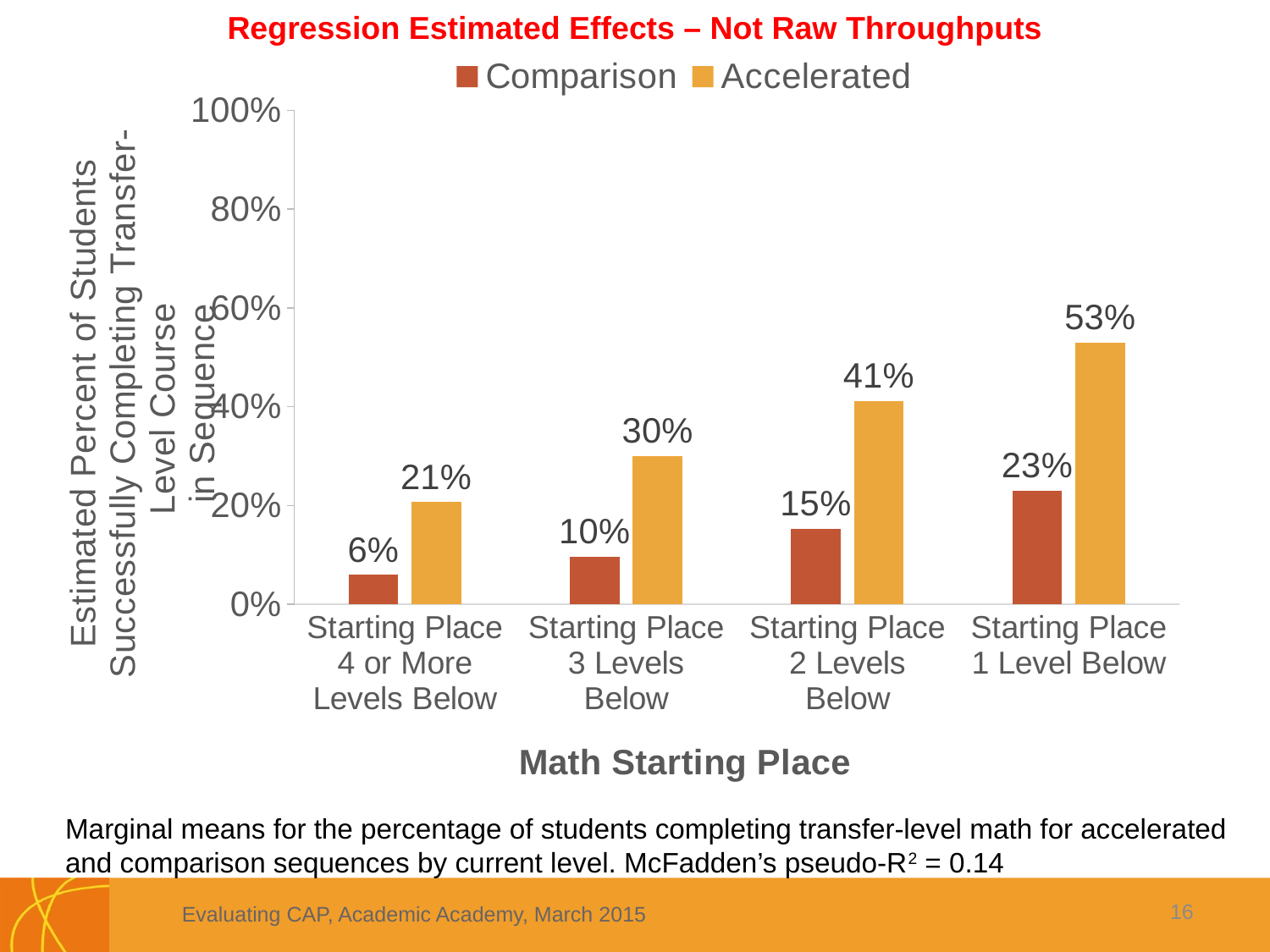
Which is larger: the Comparison value for Starting Place 1 Level Below or the Accelerated value for Starting Place 4 or More Levels Below? Comparison value for Starting Place 1 Level Below What is the difference between the Accelerated and Comparison values for Starting Place 3 Levels Below? 20% What kind of chart is shown on the slide? Bar chart What is the Accelerated value for Starting Place 2 Levels Below? 41% What is the Comparison value for Starting Place 4 or More Levels Below? 6% How many series does the legend list? 2 Which starting place has the highest Accelerated value? Starting Place 1 Level Below What is the Comparison value for Starting Place 1 Level Below? 23% How many starting place categories are shown on the x axis? 4 What is the difference between the Accelerated values for Starting Place 1 Level Below and Starting Place 2 Levels Below? 12% Which starting place has the lowest Comparison value? Starting Place 4 or More Levels Below Do the Accelerated values rise or fall moving from left to right along the x axis? Rise